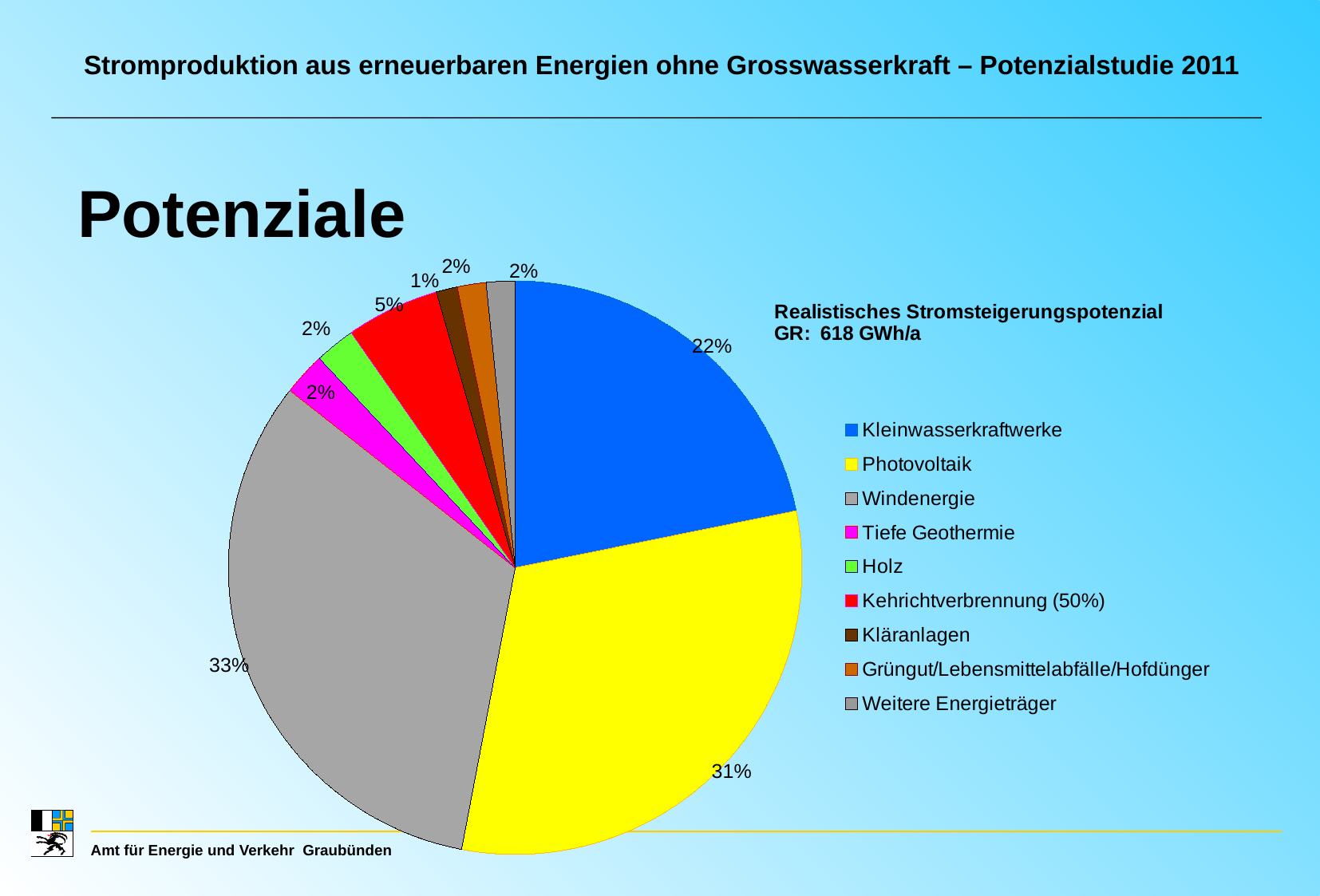
What share of the pie does Photovoltaik have? 31% What kind of chart is shown on the slide? Pie chart What share of the pie does Kleinwasserkraftwerke have? 22% Which category has the smallest share of the pie? Kläranlagen What share of the pie does Kehrichtverbrennung (50%) have? 5% Which has a larger share, Kleinwasserkraftwerke or Kehrichtverbrennung (50%)? Kleinwasserkraftwerke How many categories does the legend list? 9 Which category has the largest share of the pie? Windenergie What is the difference in percentage points between Windenergie and Photovoltaik? 2 What colour is the Photovoltaik slice? Yellow What share of the pie does Windenergie have? 33% What share of the pie does Kläranlagen have? 1%